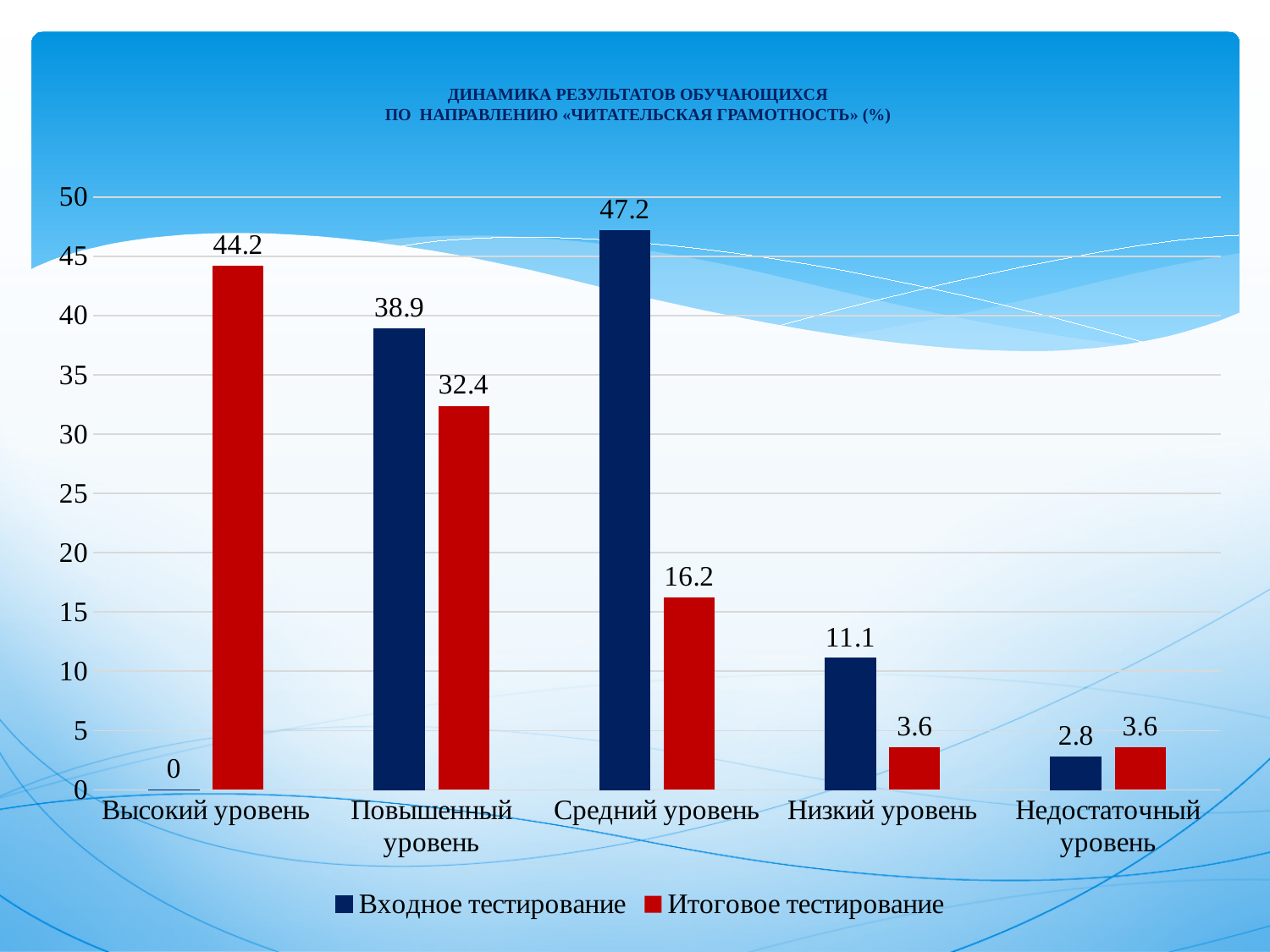
What is the value for Входное тестирование at Высокий уровень? 0 What is the difference between Итоговое тестирование and Входное тестирование at Повышенный уровень? 6.5 What is the value for Итоговое тестирование at Низкий уровень? 3.6 Which category has the highest value for Входное тестирование? Средний уровень Which category has the lowest value for Итоговое тестирование? Низкий уровень and Недостаточный уровень (both 3.6) How many series does the legend list? 2 What kind of chart is shown on the slide? Bar chart What is the difference between Входное тестирование and Итоговое тестирование at Средний уровень? 31 What is the value for Входное тестирование at Средний уровень? 47.2 Which is larger at Недостаточный уровень: Входное тестирование or Итоговое тестирование? Итоговое тестирование What is the value for Итоговое тестирование at Высокий уровень? 44.2 How many categories are shown on the x axis? 5